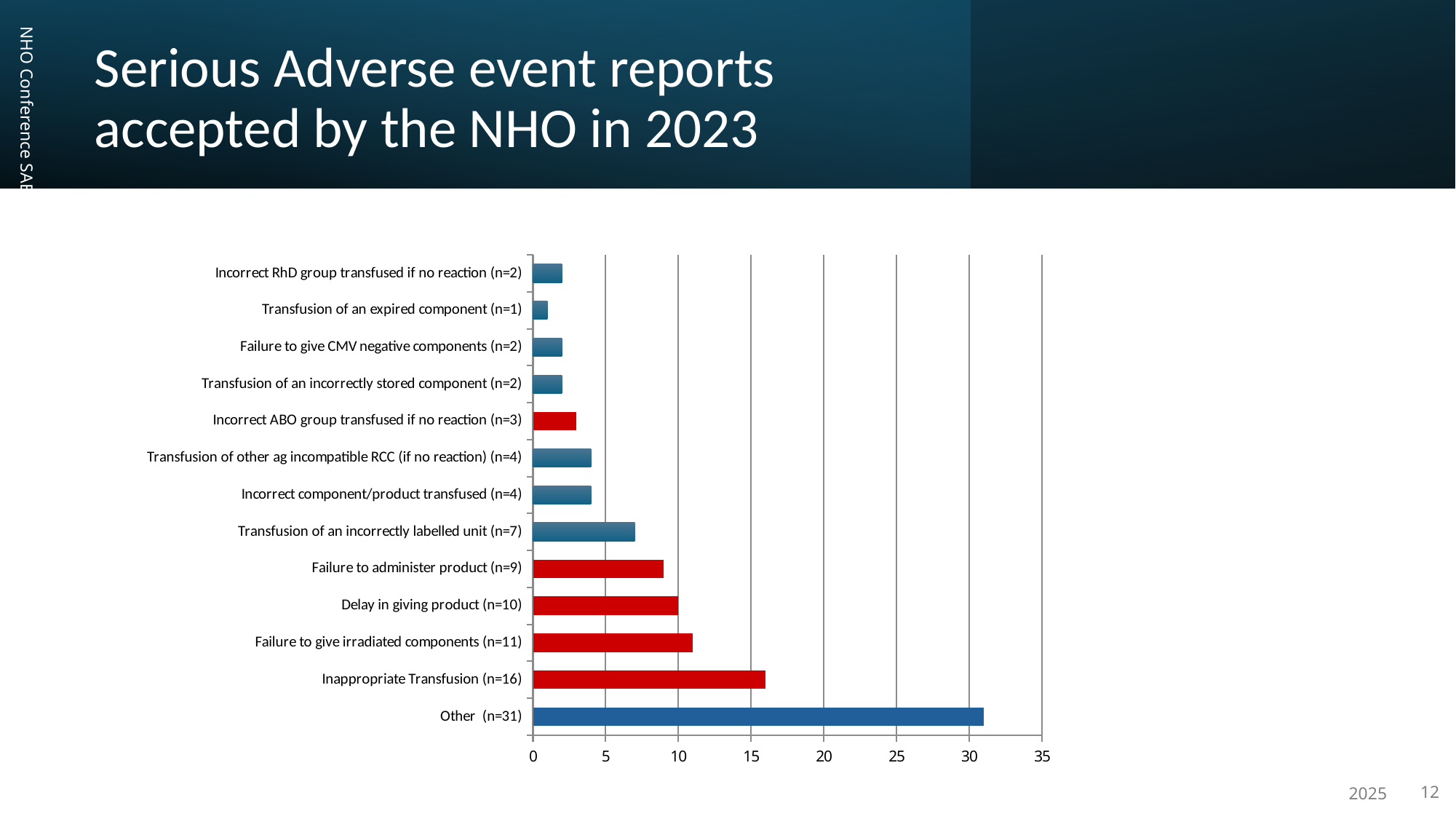
What is the title of the slide containing the chart? Serious Adverse event reports accepted by the NHO in 2023 What is the difference between the values for Other and Inappropriate Transfusion? 15 Is the value for Other greater or less than 30? greater What is the value for Failure to give irradiated components? 11 What is the value for Transfusion of an incorrectly labelled unit? 7 Which is larger, the value for Delay in giving product or the value for Failure to administer product? Delay in giving product What is the value for Inappropriate Transfusion? 16 Which category has the lowest value? Transfusion of an expired component (n=1) How many categories are plotted in the chart? 13 What is the difference between the values for Failure to give irradiated components and Incorrect ABO group transfused if no reaction? 8 Which category has the highest value? Other (n=31) What kind of chart is shown on the slide? bar chart